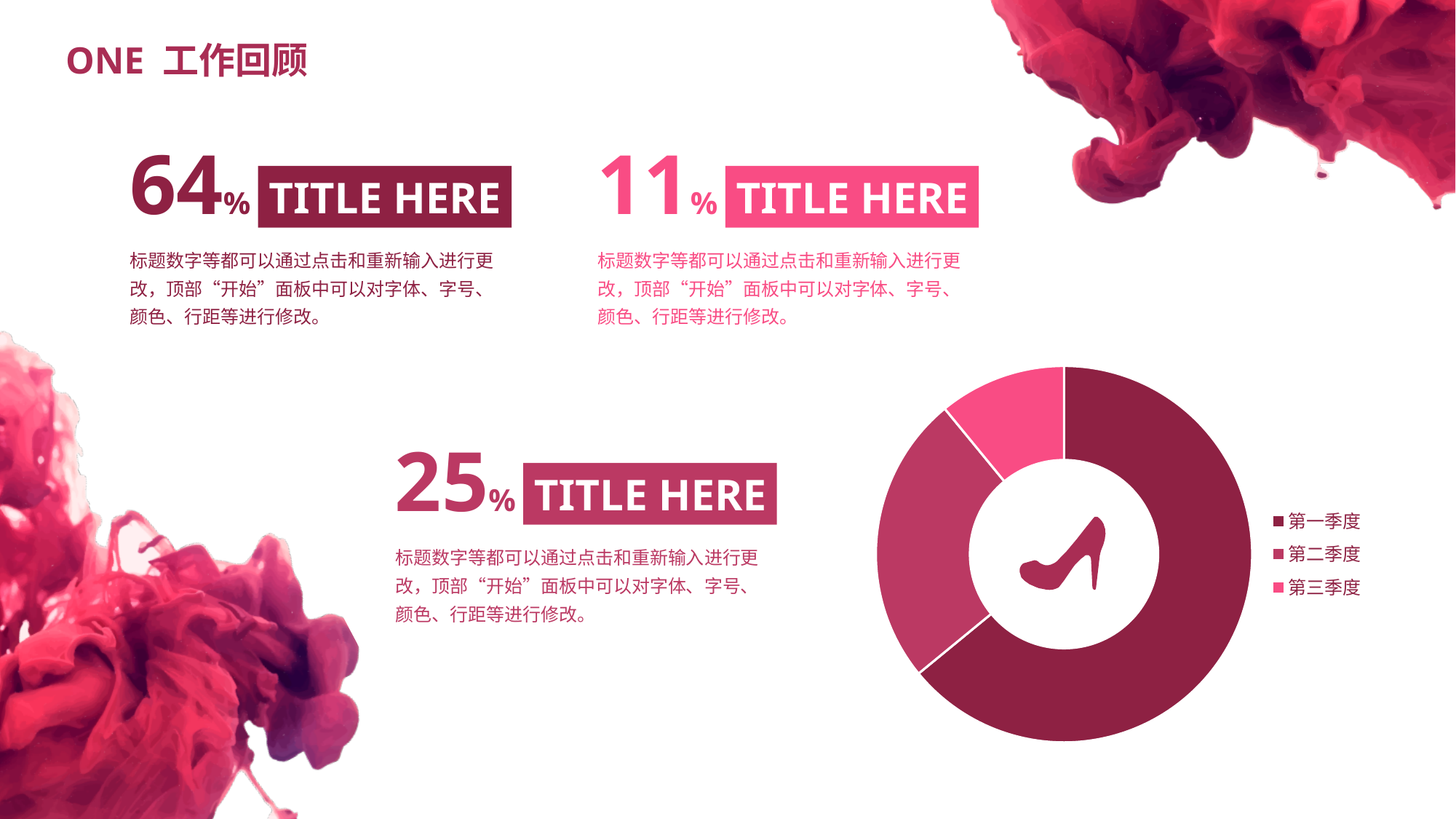
Which category has the largest slice in the doughnut chart? 第一季度 Which legend entry of the doughnut chart is shown in the lightest pink colour? 第三季度 How many categories does the doughnut chart have? 3 Which slice is larger in the doughnut chart, 第二季度 or 第三季度? 第二季度 How many entries does the legend of the doughnut chart list? 3 What kind of chart is shown on the slide? Doughnut chart Which category has the smallest slice in the doughnut chart? 第三季度 What are the legend entries of the doughnut chart, in order? 第一季度, 第二季度, 第三季度 Which slice is larger in the doughnut chart, 第一季度 or 第二季度? 第一季度